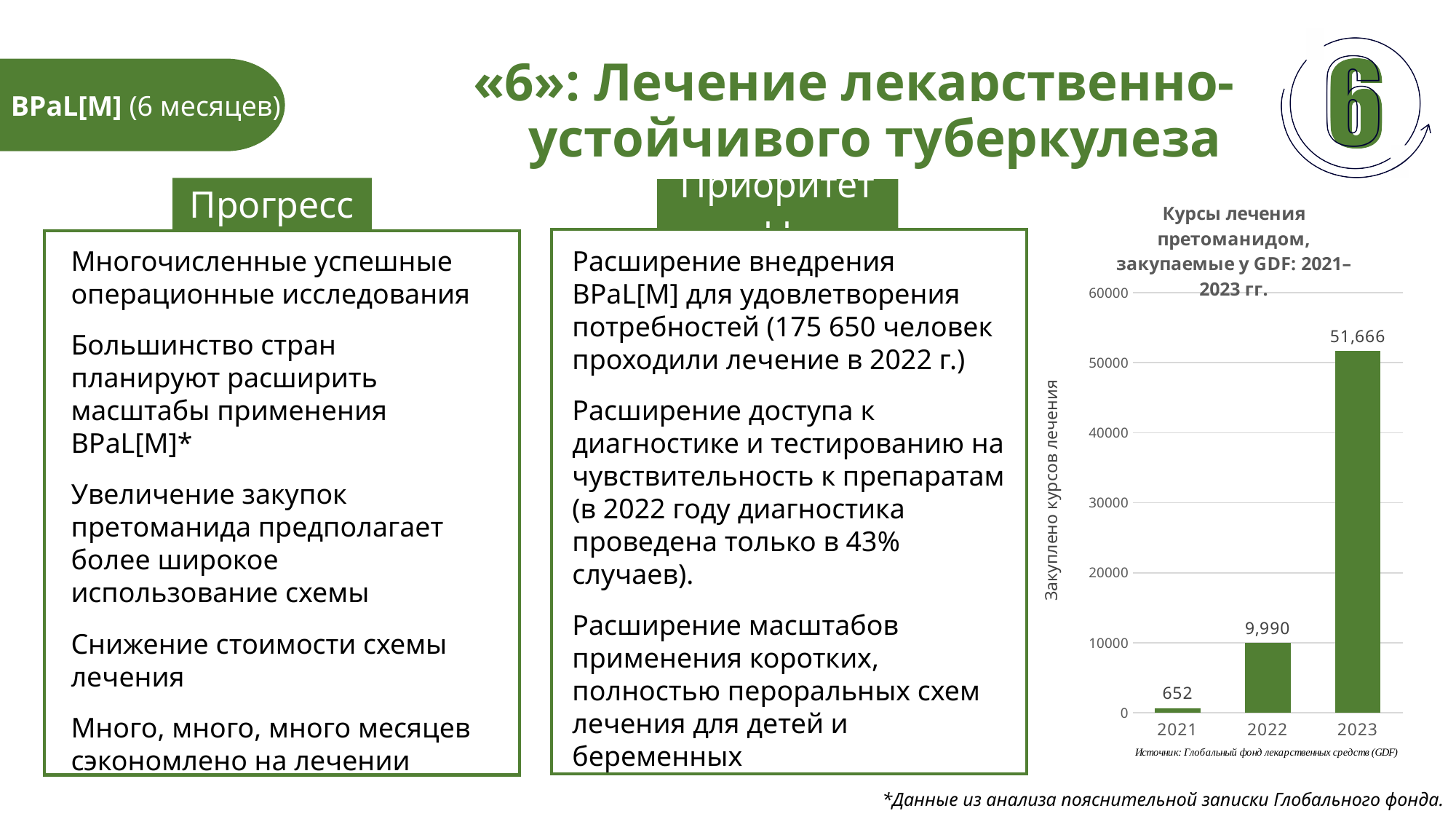
What is the value for 2022? 9,990 Do the values rise or fall from 2021 to 2023? rise How many years are shown on the x axis? 3 What kind of chart is shown? bar chart Which year has the highest value? 2023 What is the difference between the values for 2022 and 2021? 9,338 What is the difference between the values for 2023 and 2022? 41,676 Which is larger, the value for 2022 or the value for 2021? 2022 Which year has the lowest value? 2021 What is the value for 2021? 652 Is the value for 2023 greater or less than 50000? greater What is the value for 2023? 51,666